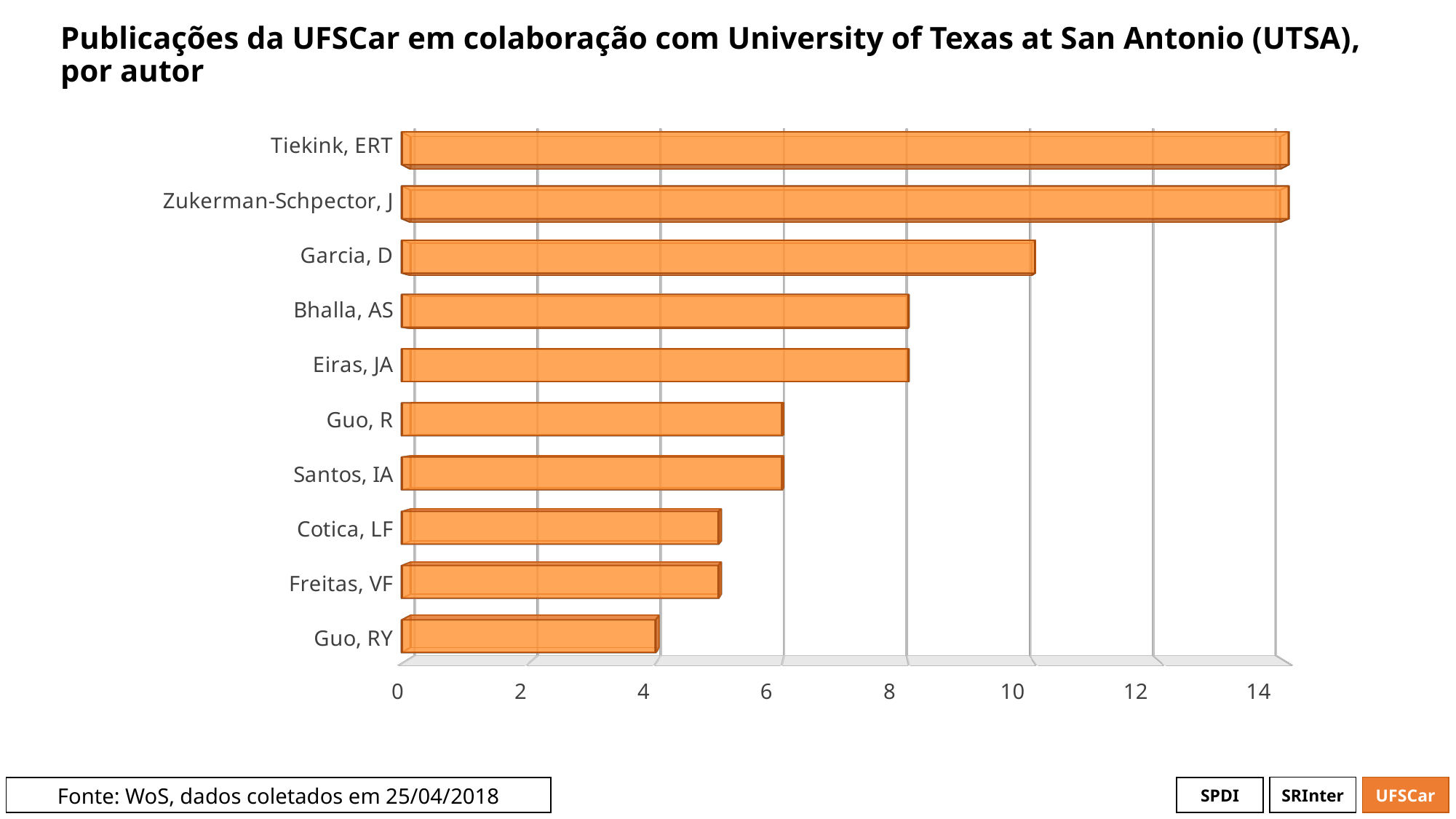
How many authors are listed on the chart? 10 How many publications does Tiekink, ERT have? 14 Who has more publications, Garcia, D or Bhalla, AS? Garcia, D How many publications does Bhalla, AS have? 8 How many publications does Garcia, D have? 10 Is the value for Cotica, LF greater or less than 4? greater Who has more publications, Santos, IA or Guo, RY? Santos, IA Which author has the lowest number of publications? Guo, RY What is the difference between the publications of Garcia, D and Guo, RY? 6 What kind of chart is shown on the slide? bar chart Is the value for Freitas, VF greater or less than 6? less How many publications does Guo, RY have? 4